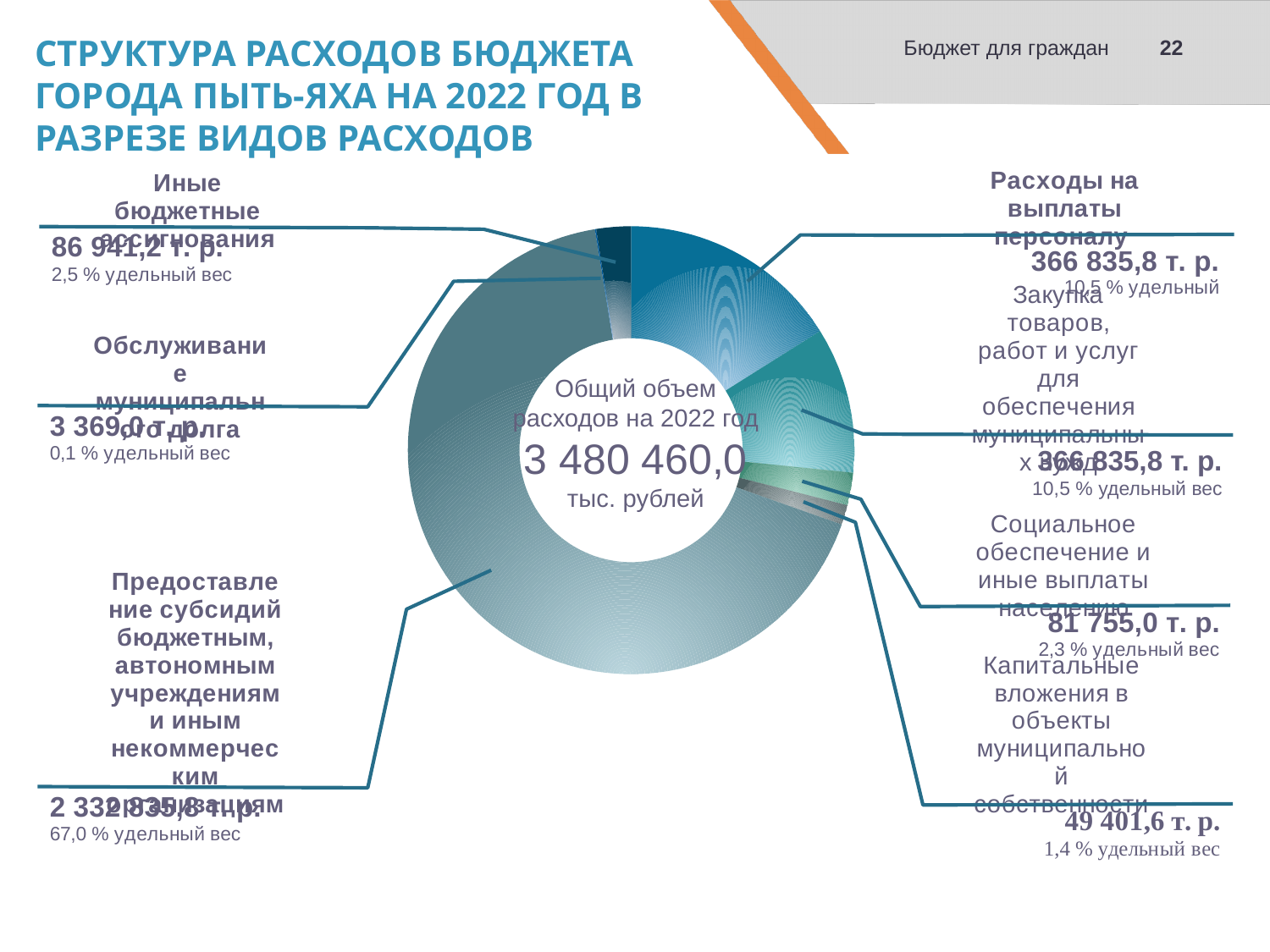
What is the value for «Обслуживание муниципального долга»? 3 369,0 т. р. What share of the budget does «Предоставление субсидий бюджетным, автономным учреждениям и иным некоммерческим организациям» account for? 67,0 % What is the value for «Социальное обеспечение и иные выплаты населению»? 81 755,0 т. р. What is the value for «Расходы на выплаты персоналу»? 366 835,8 т. р. Which expenditure type has the smallest share of the budget? Обслуживание муниципального долга What is the value for «Капитальные вложения в объекты муниципальной собственности»? 49 401,6 т. р. What is the total volume of expenditures for 2022 shown in the centre of the chart? 3 480 460,0 тыс. рублей How many expenditure types are shown in the chart? 7 What kind of chart is shown on the slide? Pie (donut) chart Which expenditure type has the largest share of the budget? Предоставление субсидий бюджетным, автономным учреждениям и иным некоммерческим организациям What is the value for «Предоставление субсидий бюджетным, автономным учреждениям и иным некоммерческим организациям»? 2 332 835,8 т. р. What is the difference between «Иные бюджетные ассигнования» (86 941,2 т. р.) and «Социальное обеспечение и иные выплаты населению» (81 755,0 т. р.)? 5 186,2 т. р.